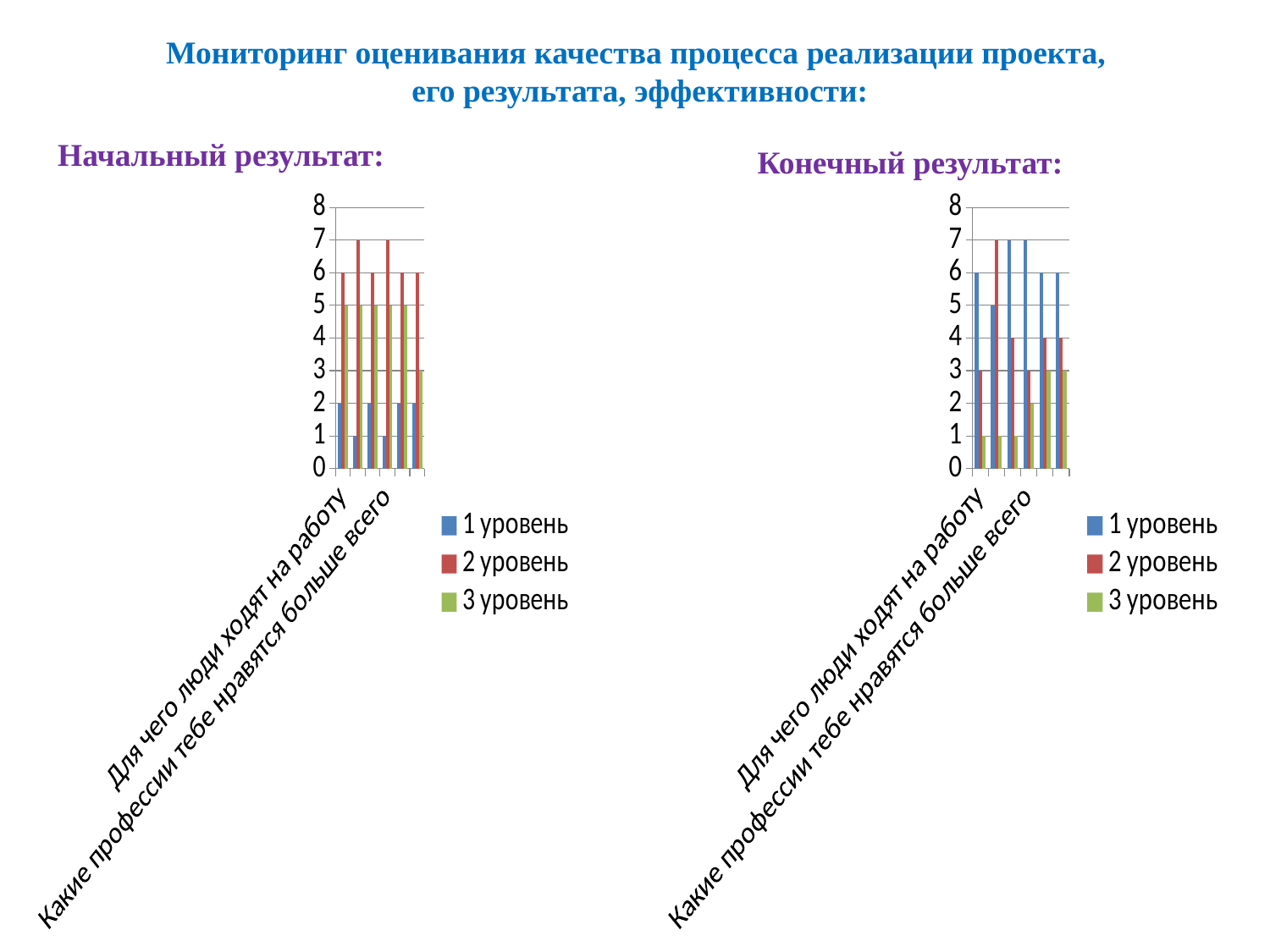
What is the maximum value shown on the vertical axis of the "Конечный результат" chart? 8 Which legend entry is shown in green in the "Начальный результат" chart? 3 уровень How many series does the legend of the "Конечный результат" chart list? 3 What kind of chart is the "Начальный результат" chart? bar chart What kind of chart is the "Конечный результат" chart? bar chart In the "Начальный результат" chart, are the bars for "2 уровень" higher or lower than the bars for "1 уровень"? higher In the "Начальный результат" chart, which series has the tallest bars? 2 уровень In the "Начальный результат" chart, what is the highest value reached by any bar? 7 How many series does the legend of the "Начальный результат" chart list? 3 In the "Конечный результат" chart, what is the highest value reached by any bar? 7 In the "Конечный результат" chart, are the bars for "1 уровень" higher or lower than the bars for "3 уровень"? higher